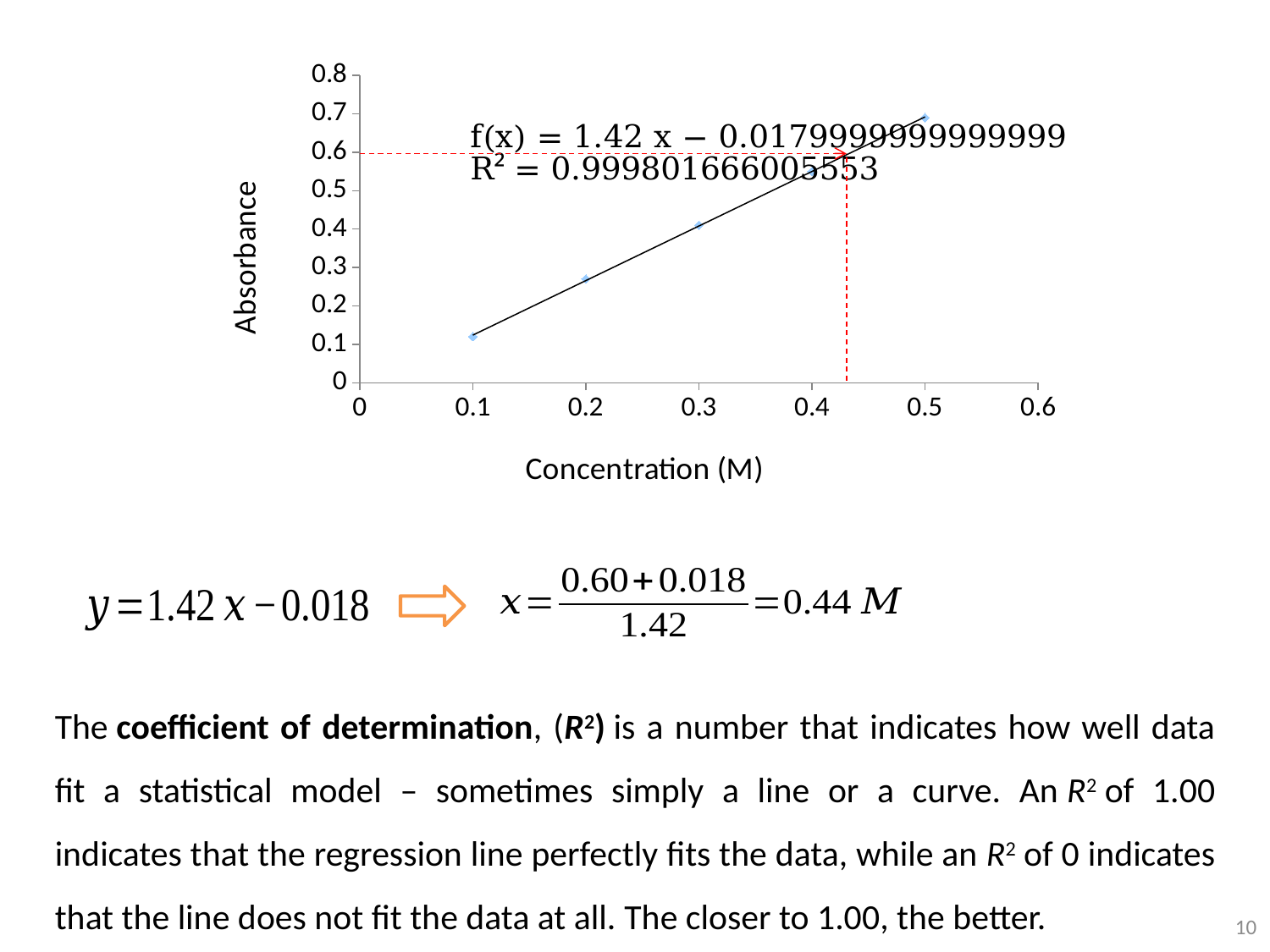
At which concentration is the absorbance lowest? 0.1 What is the label of the x axis? Concentration (M) At which concentration is the absorbance highest? 0.5 How many data points are plotted on the chart? 5 Is the absorbance at a concentration of 0.1 M greater or less than 0.2? less Is the absorbance at a concentration of 0.2 M greater or less than 0.2? greater Is the absorbance at a concentration of 0.5 M greater or less than 0.6? greater What slope does the trendline equation shown on the chart give? 1.42 Which has the larger absorbance, the point at 0.2 M or the point at 0.4 M? 0.4 M What is the label of the y axis? Absorbance Does absorbance rise or fall as concentration increases along the x axis? rise What kind of chart is shown on the slide? scatter chart